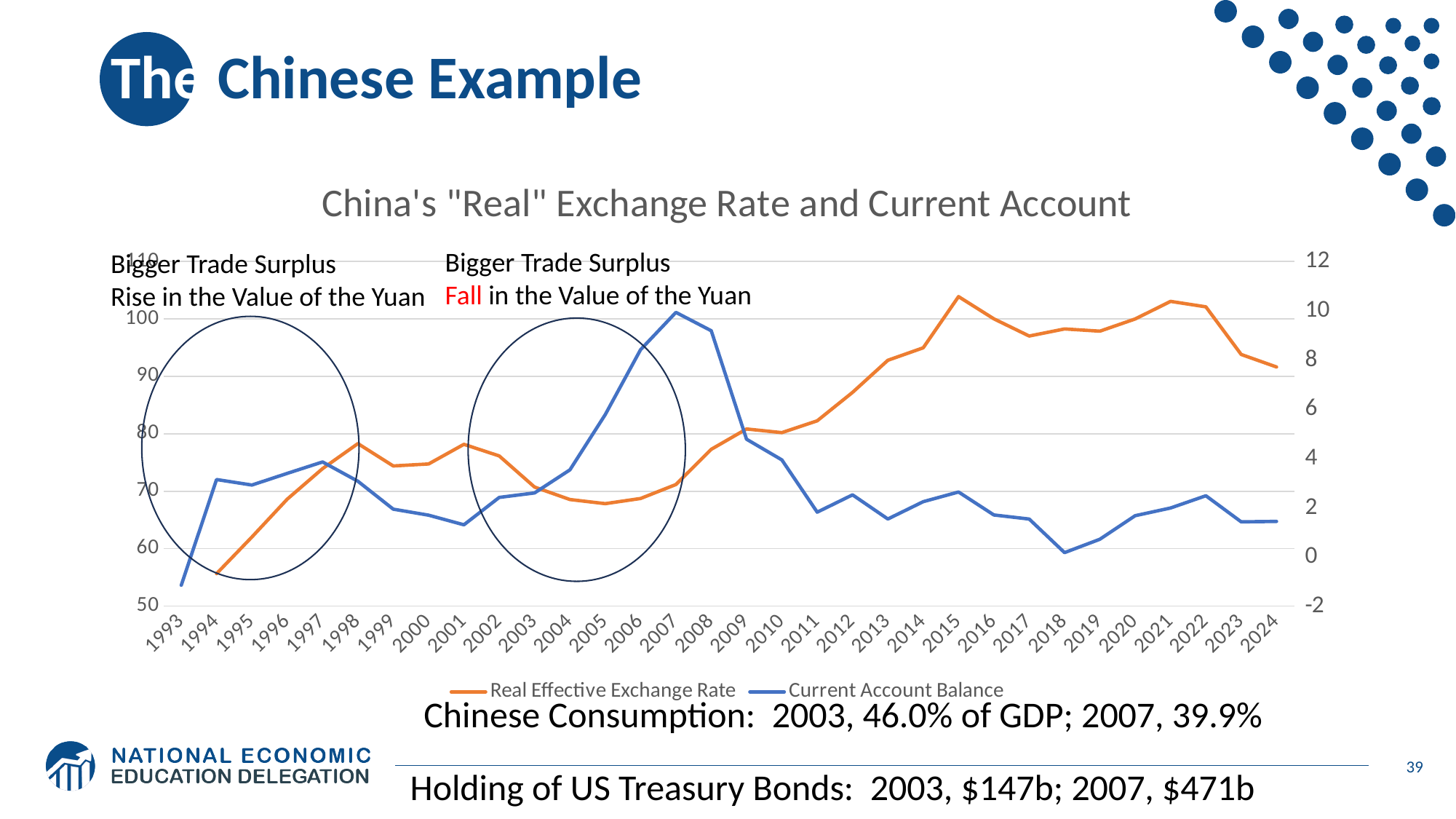
In which year is the Current Account Balance at its lowest? 1993 Is the Current Account Balance in 2007 greater or less than 8 on the right axis? greater Which series is drawn in orange? Real Effective Exchange Rate How many years are labelled along the x axis of the chart? 32 What kind of chart is shown on the slide? line chart In which year is the Real Effective Exchange Rate at its lowest? 1994 In which year does the Current Account Balance reach its highest value? 2007 Which is larger, the Current Account Balance in 2007 or in 2024? 2007 How many series does the chart legend list? 2 Does the Real Effective Exchange Rate rise or fall between 2005 and 2015? rise Is the Real Effective Exchange Rate in 2015 greater or less than 100? greater What is the title of the chart? China's "Real" Exchange Rate and Current Account